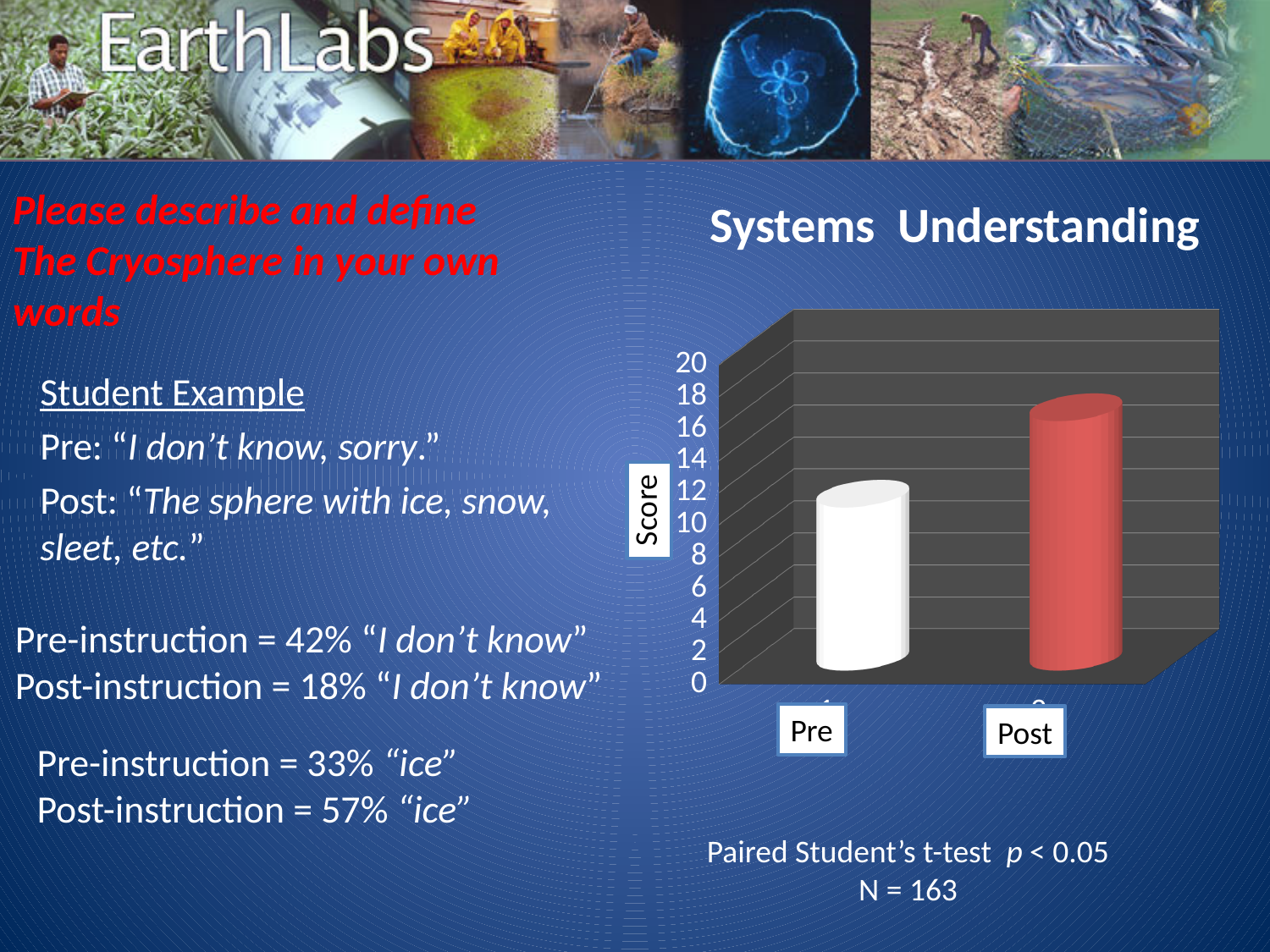
Is the score for Post greater or less than 14? greater Is the score for Pre greater or less than 8? greater Which category has the highest score in the chart? Post How many bars are plotted in the chart? 2 Is the score for Pre greater or less than 14? less What is the title of the chart? Systems Understanding What is the label on the vertical axis of the chart? Score Which category has the lowest score in the chart? Pre What kind of chart is shown on the slide? bar chart Which is larger, the score for Pre or the score for Post? Post Does the score rise or fall from Pre to Post? rise